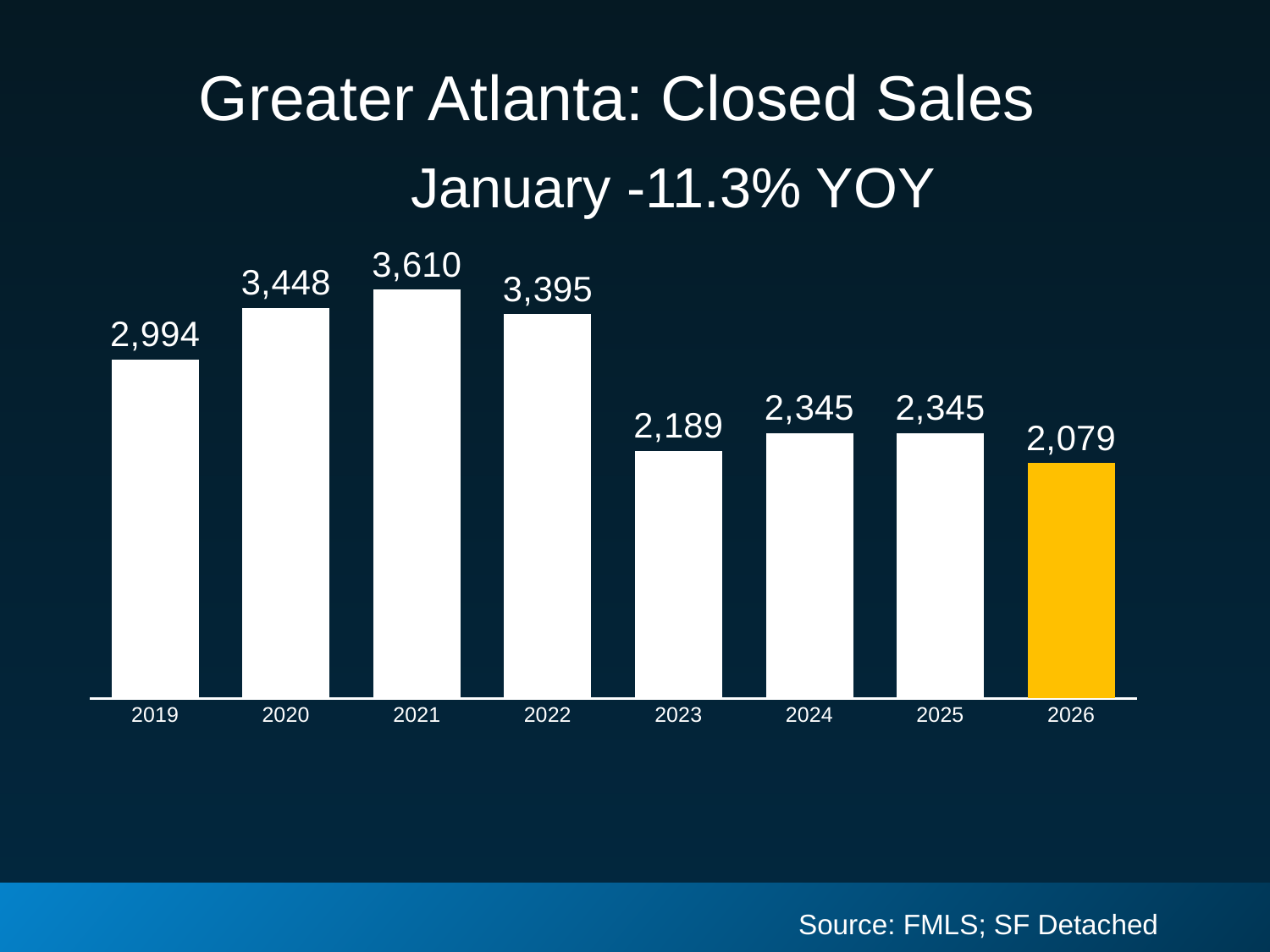
What is the difference between the values for 2021 and 2019? 616 Which year has the lowest closed sales? 2026 Do the values rise or fall from 2022 to 2023? fall What is the value for 2023? 2,189 What is the value for 2019? 2,994 What is the value for 2026? 2,079 How many years are shown on the x axis? 8 What kind of chart is this? bar chart Which year has the highest closed sales? 2021 Which bar is coloured differently from the others? 2026 What is the difference between the values for 2025 and 2026? 266 Which is larger, the value for 2020 or the value for 2022? 2020